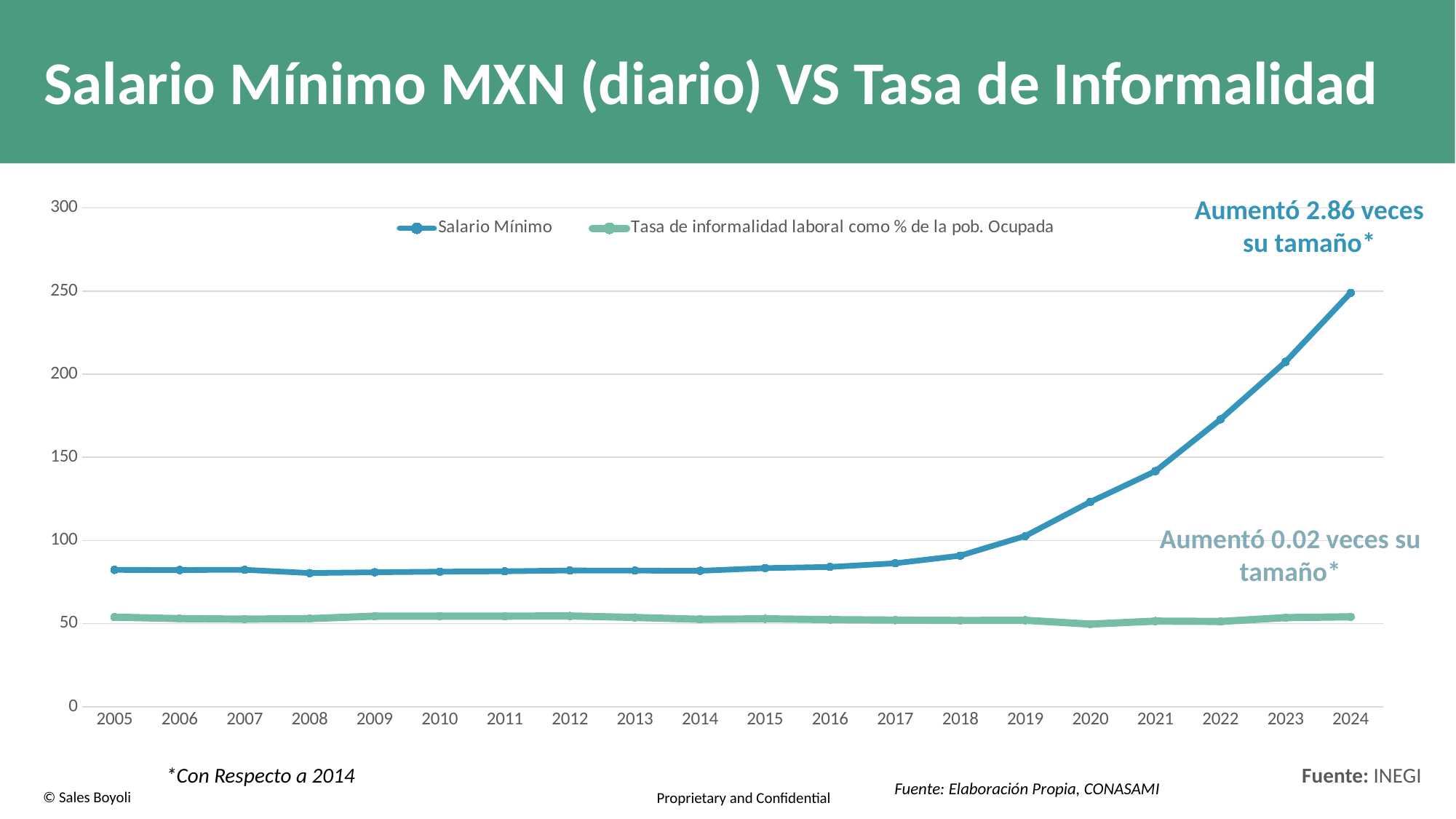
Does the Salario Mínimo series rise or fall between 2018 and 2024? rise Which series has the larger value in 2024, Salario Mínimo or Tasa de informalidad laboral? Salario Mínimo Is the value for Salario Mínimo in 2024 greater or less than 200? greater Is the value for Salario Mínimo in 2005 greater or less than 100? less Is the value for Salario Mínimo in 2022 greater or less than 150? greater How many series does the legend list? 2 How many years are plotted along the x axis? 20 According to the annotation on the chart, by how many times did the Salario Mínimo increase its size with respect to 2014? 2.86 veces What kind of chart is shown on the slide? line chart In which year is the Salario Mínimo series at its highest? 2024 In which year is the Tasa de informalidad laboral series at its lowest? 2020